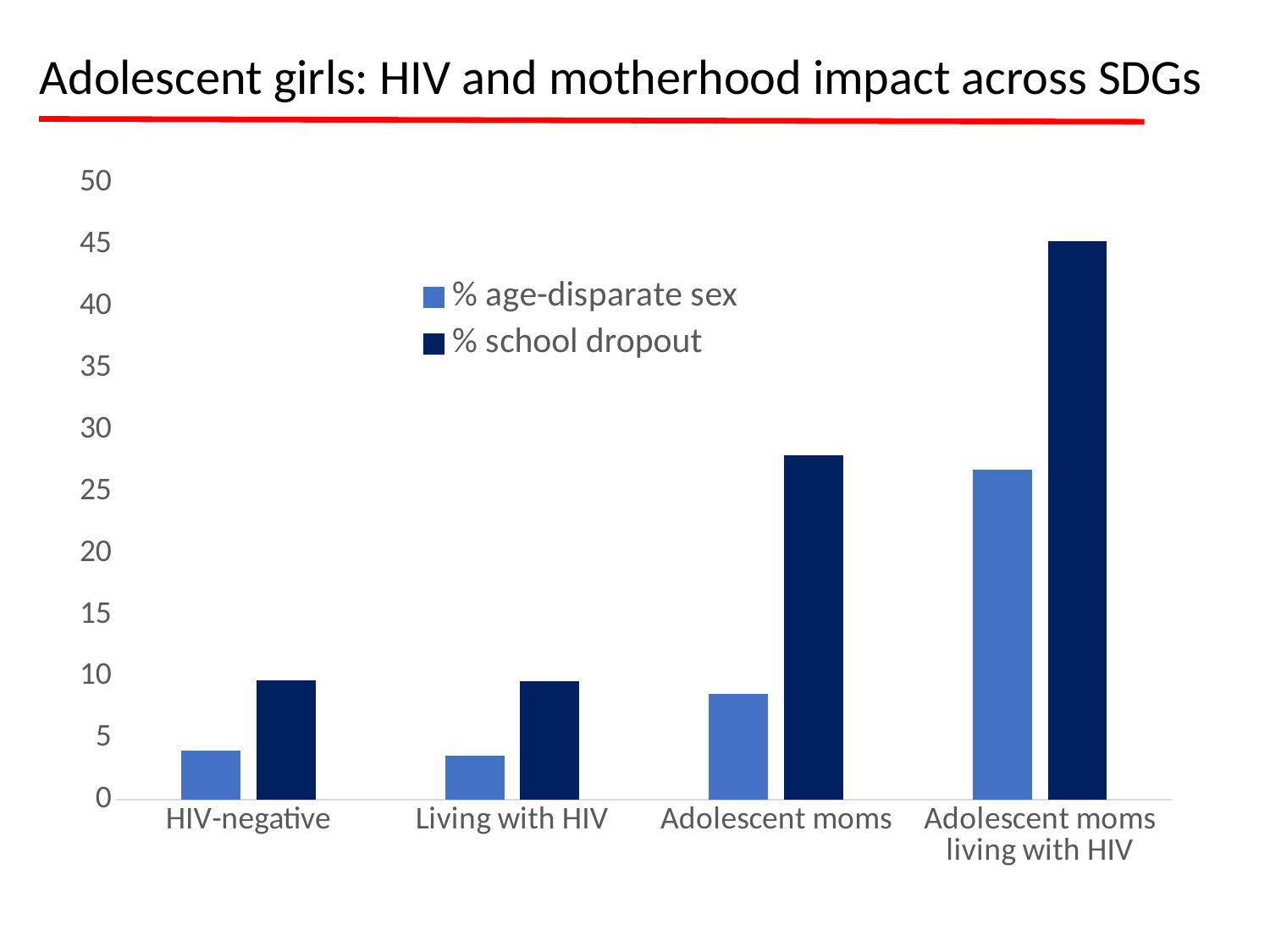
Which is larger: the % school dropout for Adolescent moms or for HIV-negative? Adolescent moms Is the % school dropout for HIV-negative greater or less than 15? less How many categories are shown on the x axis? 4 How many series does the legend list? 2 Which category has the highest % age-disparate sex? Adolescent moms living with HIV What is the title of the slide containing the chart? Adolescent girls: HIV and motherhood impact across SDGs Is the % age-disparate sex for Adolescent moms living with HIV greater or less than 20? greater What kind of chart is shown on the slide? bar chart Is the % school dropout for Adolescent moms living with HIV greater or less than 40? greater Which is larger: the % age-disparate sex for Adolescent moms or for Adolescent moms living with HIV? Adolescent moms living with HIV Which category has the highest % school dropout? Adolescent moms living with HIV